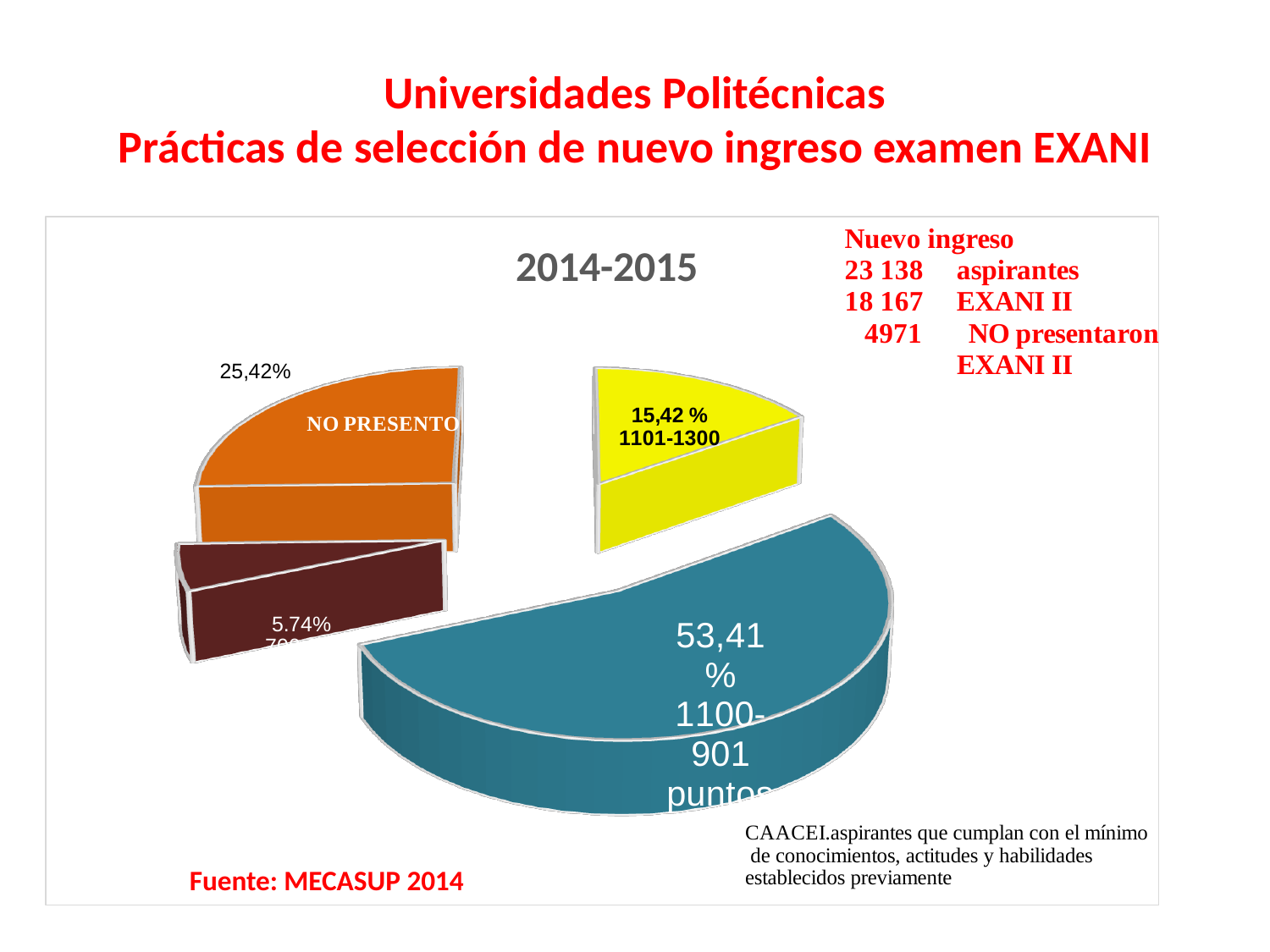
What percentage of the pie is labelled NO PRESENTO? 25,42% Is the share of the 1100-901 puntos slice greater or less than 50%? greater How many slices does the pie chart have? 4 What percentage is shown for the 1101-1300 slice? 15,42 % What kind of chart is shown on the slide? Pie chart What colour is the 1101-1300 slice? Yellow What is the difference in percentage points between the 1100-901 puntos slice and the 1101-1300 slice? 37,99 Which slice of the pie chart is the largest? 1100-901 puntos Which is larger, the NO PRESENTO slice or the 1101-1300 slice? NO PRESENTO What percentage is shown for the 1100-901 puntos slice? 53,41 % What is the title of the pie chart? 2014-2015 What is the smallest percentage shown on the pie chart? 5.74%